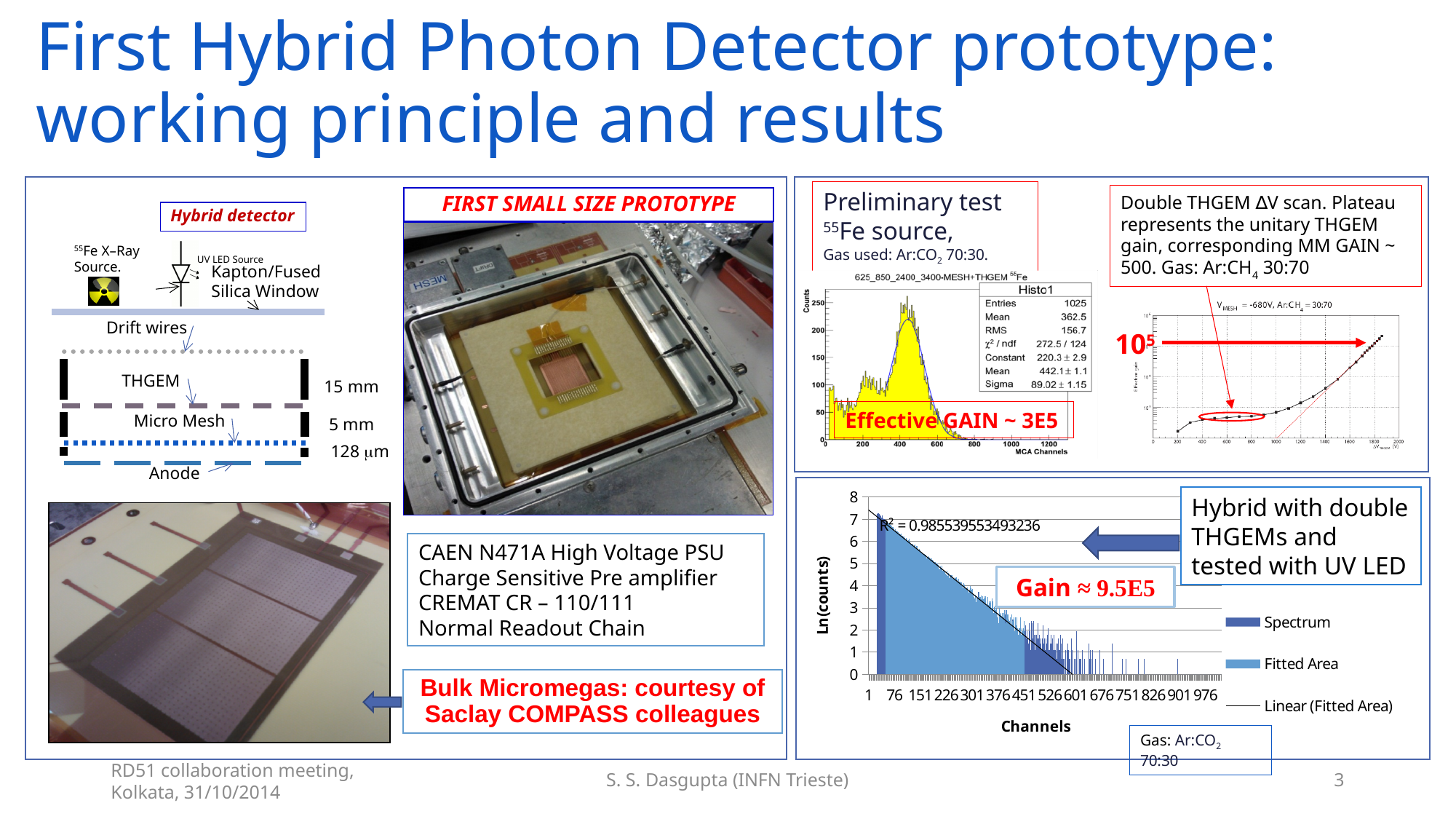
In the bottom-right chart of Ln(counts) versus Channels, do the values rise or fall as the channel number increases? fall In the bottom-right chart of Ln(counts) versus Channels, what is the label of the y axis? Ln(counts) In the bottom-right chart of Ln(counts) versus Channels, what R² value is printed on the chart? R² = 0.985539553493236 In the 55Fe source histogram (top middle), what is the fitted Sigma value listed in the statistics box? 89.02 ± 1.15 In the Double THGEM ΔV scan plot (top right), does the effective gain rise or fall as ΔV increases? rise In the 55Fe source histogram (top middle), how many entries are listed in the statistics box? 1025 In the bottom-right chart of Ln(counts) versus Channels, how many entries does the legend list? 3 In the 55Fe source histogram (top middle), what effective gain is stated on the chart? Effective GAIN ~ 3E5 In the bottom-right chart of Ln(counts) versus Channels, what are the three legend entries? Spectrum, Fitted Area, Linear (Fitted Area) In the 55Fe source histogram (top middle), what is the RMS value listed in the statistics box? 156.7 In the bottom-right chart of Ln(counts) versus Channels, what is the highest tick value shown on the y axis? 8 In the bottom-right chart of Ln(counts) versus Channels, what gain value is stated in the box on the chart? Gain ≈ 9.5E5